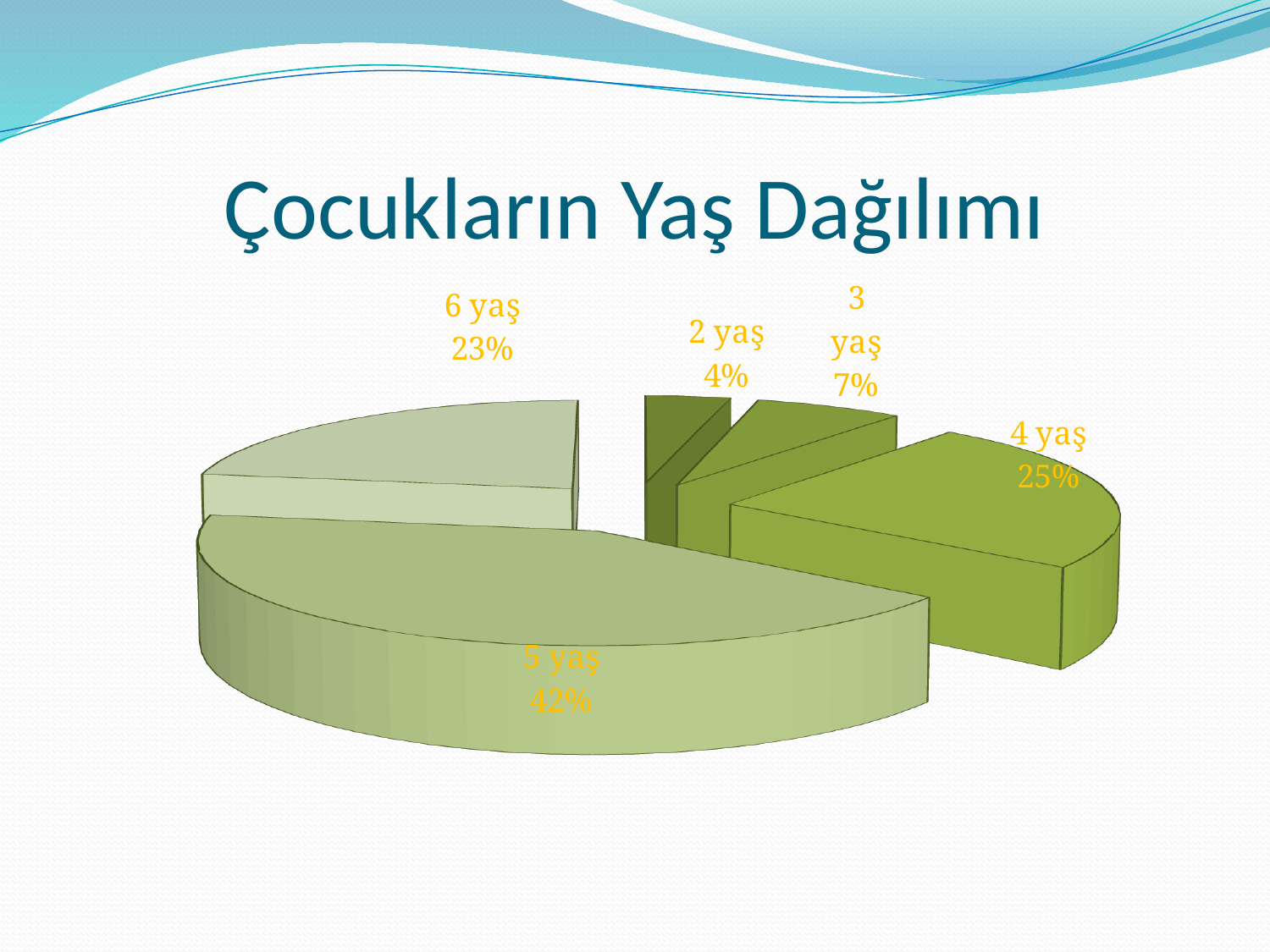
What share of the pie does the 4 yaş slice have? 25% Which age group has the smallest share of the pie? 2 yaş How many slices does the pie chart have? 5 Which age group has the largest share of the pie? 5 yaş What share of the pie does the 6 yaş slice have? 23% What share of the pie does the 5 yaş slice have? 42% Which slice is larger, 4 yaş or 6 yaş? 4 yaş What is the difference in percentage points between the 5 yaş and 4 yaş slices? 17 What is the title of the chart? Çocukların Yaş Dağılımı What kind of chart is shown on the slide? Pie chart